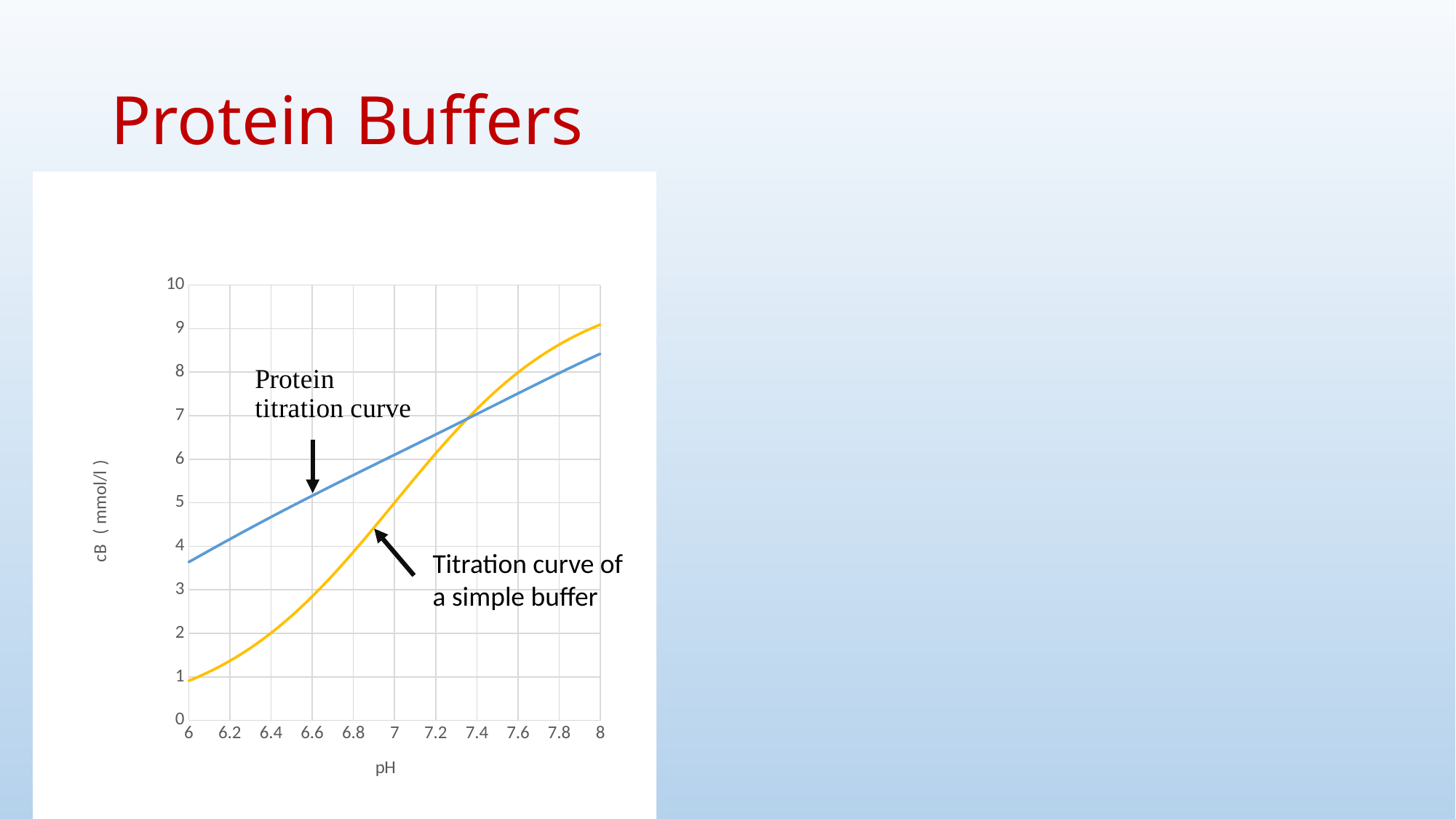
What kind of chart is shown on the slide? line chart At pH 6, is the value of the protein titration curve greater or less than 3? greater Does the protein titration curve rise or fall as pH increases from 6 to 8? rise What is the label of the x axis? pH Does the titration curve of a simple buffer rise or fall as pH increases from 6 to 8? rise What is the label of the y axis? cB ( mmol/l ) At pH 6.4, which curve has the higher value, the protein titration curve or the titration curve of a simple buffer? Protein titration curve How many curves are plotted on the chart? 2 At pH 7.8, which curve has the higher value, the protein titration curve or the titration curve of a simple buffer? Titration curve of a simple buffer